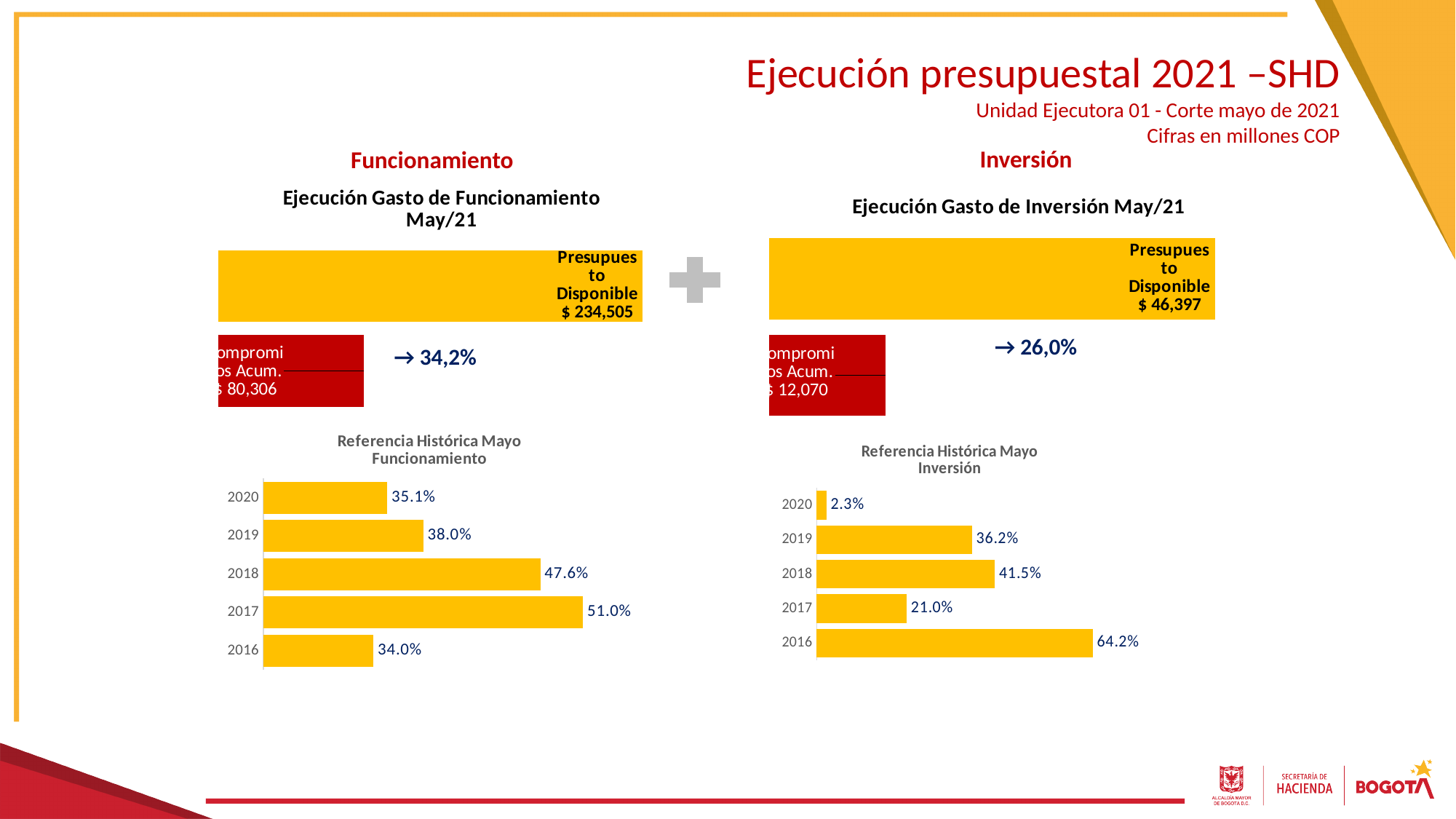
In the 'Referencia Histórica Mayo Inversión' chart, which year has the lowest value? 2020 In the 'Referencia Histórica Mayo Funcionamiento' chart, what is the value for 2017? 51.0% In the 'Referencia Histórica Mayo Inversión' chart, which year has the highest value? 2016 In the 'Referencia Histórica Mayo Funcionamiento' chart, which year has the highest value? 2017 In the 'Referencia Histórica Mayo Inversión' chart, what is the value for 2020? 2.3% In the 'Referencia Histórica Mayo Funcionamiento' chart, what is the difference between the values for 2018 and 2019? 9.6% In the 'Ejecución Gasto de Funcionamiento May/21' chart, what is the value of Presupuesto Disponible? $ 234,505 What kind of chart is 'Referencia Histórica Mayo Inversión'? Bar chart How many years are shown in the 'Referencia Histórica Mayo Funcionamiento' chart? 5 In the 'Referencia Histórica Mayo Inversión' chart, what is the difference between the values for 2016 and 2017? 43.2% In the 'Referencia Histórica Mayo Inversión' chart, which is larger, the value for 2018 or the value for 2019? 2018 In the 'Ejecución Gasto de Inversión May/21' chart, what is the value of Presupuesto Disponible? $ 46,397